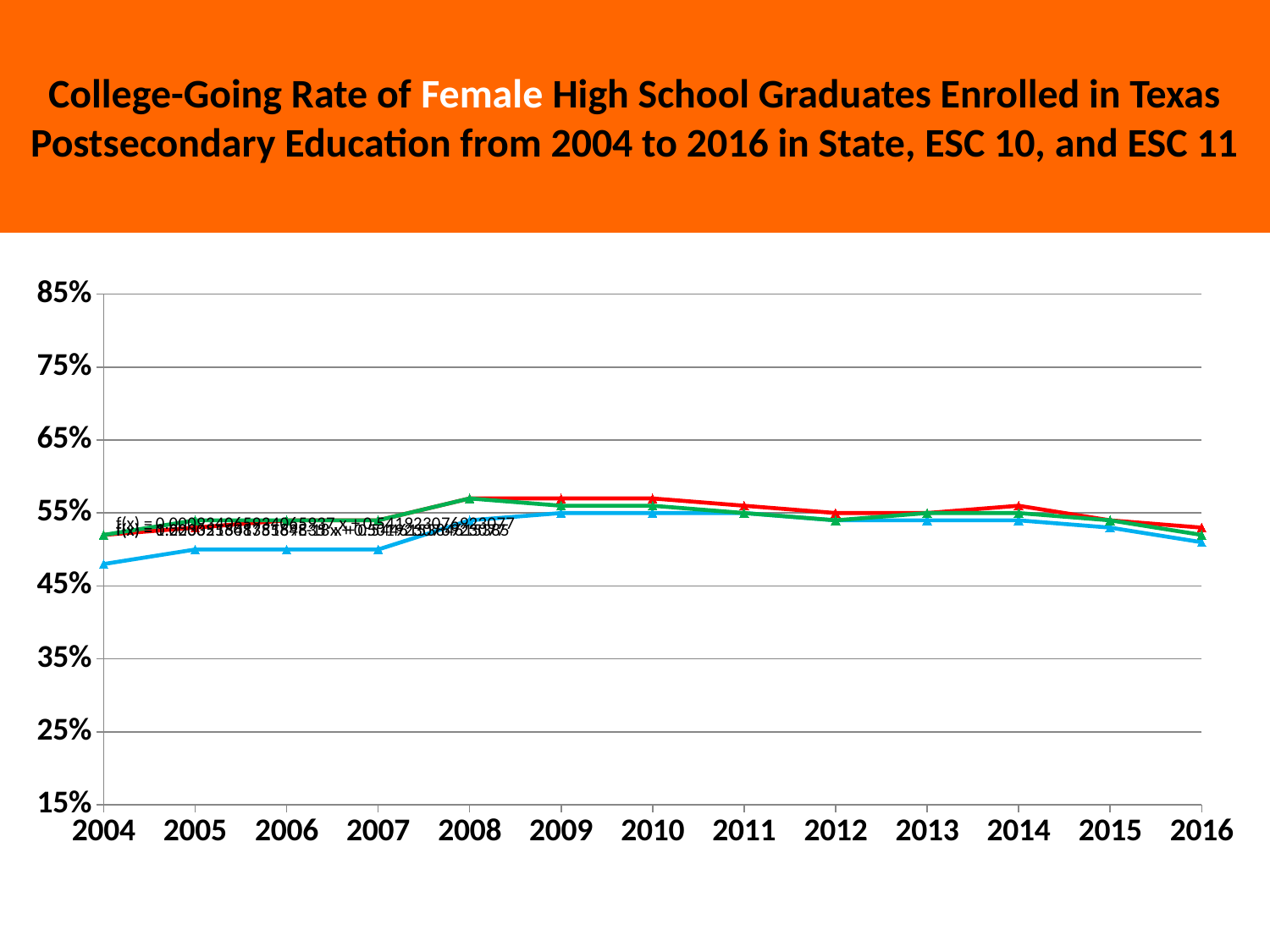
How many lines are plotted on the chart? 3 Is the value of the red line in 2009 greater or less than 55%? greater How many years are shown along the x axis of the chart? 13 Is the value of the blue line in 2007 greater or less than 55%? less What is the last year shown on the x axis? 2016 In 2004, which is higher, the blue line or the red line? the red line In which year is the blue line at its lowest value? 2004 Is the value of the blue line in 2004 greater or less than 45%? greater Does the blue line rise or fall from 2004 to 2008? rise What kind of chart is shown on the slide? line chart What is the first year shown on the x axis? 2004